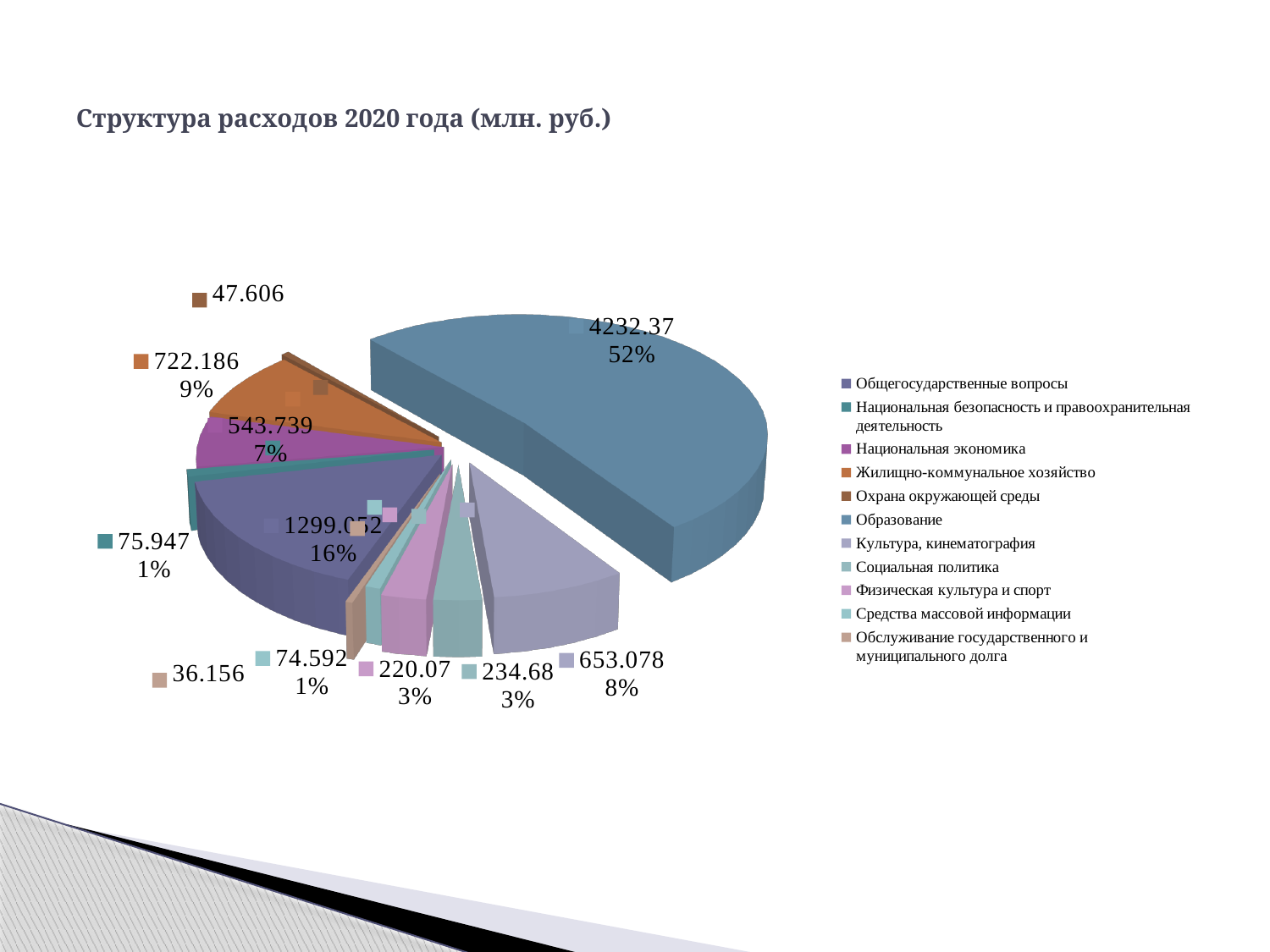
Which category has the smallest slice of the pie? Обслуживание государственного и муниципального долга How many categories does the legend of the pie chart list? 11 Which category has the largest slice of the pie? Образование What kind of chart is shown on the slide? pie chart What is the value for Образование? 4232.37 What is the value for Культура, кинематография? 653.078 What is the value for Жилищно-коммунальное хозяйство? 722.186 What is the title of the chart? Структура расходов 2020 года (млн. руб.) What is the difference between the values for Социальная политика and Физическая культура и спорт? 14.61 Which is larger, the value for Социальная политика or the value for Физическая культура и спорт? Социальная политика What share of the pie does Общегосударственные вопросы represent? 16% What share of the pie does Образование represent? 52%